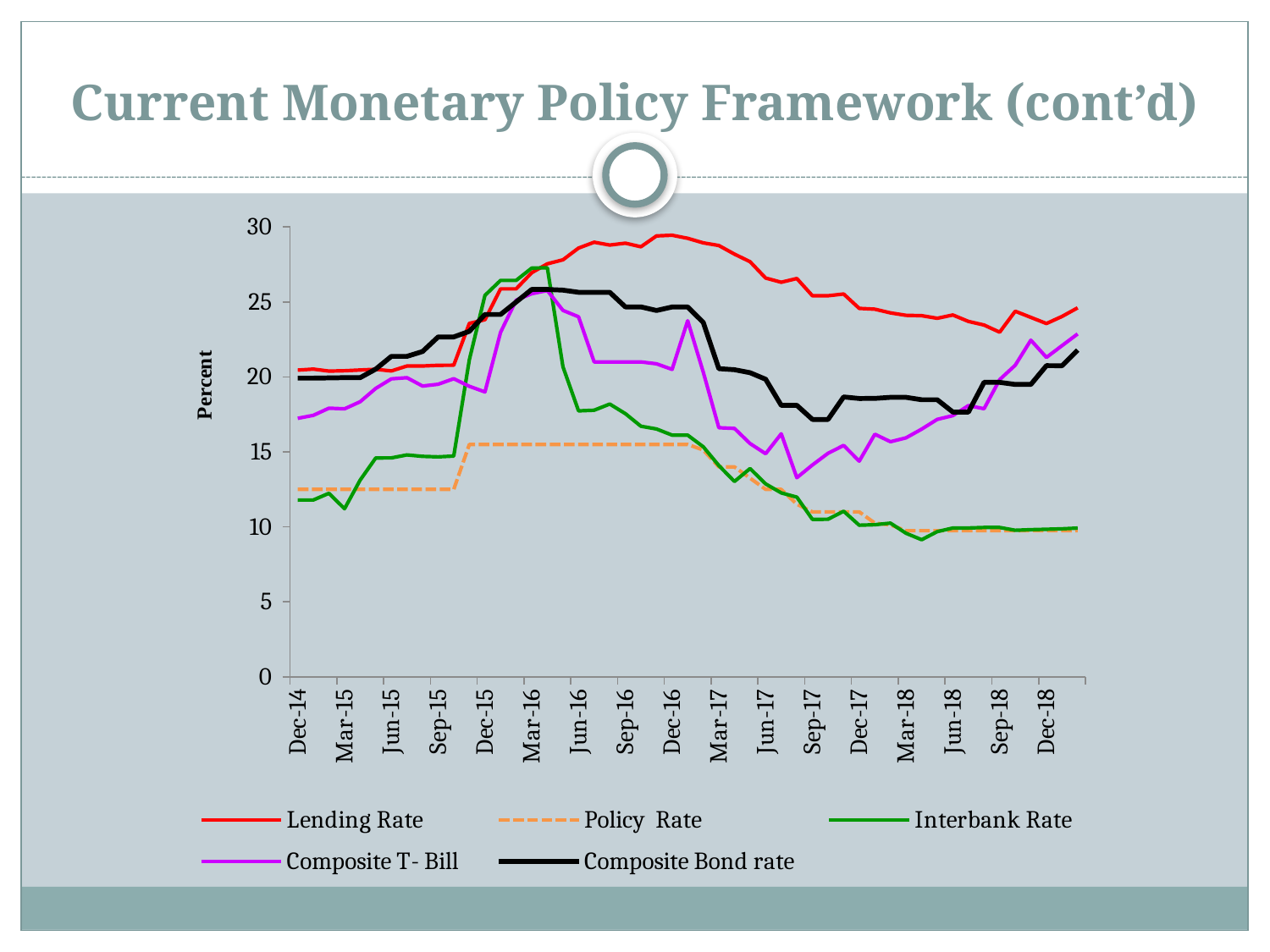
Is the Interbank Rate at Dec-18 greater or less than 15? less What kind of chart is shown on the slide? line chart How many labelled ticks are there on the horizontal axis? 17 How many series does the legend list? 5 Which series is drawn as a dashed line? Policy Rate What is the label on the vertical axis? Percent Is the Lending Rate at Dec-16 greater or less than 25? greater Which series has the lowest value at Dec-14? Interbank Rate Does the Lending Rate rise or fall between Dec-16 and Sep-18? fall At Jun-16, which is higher: the Interbank Rate or the Composite Bond rate? Composite Bond rate Is the Policy Rate at Dec-14 greater or less than 15? less Which series has the highest value at Dec-16? Lending Rate